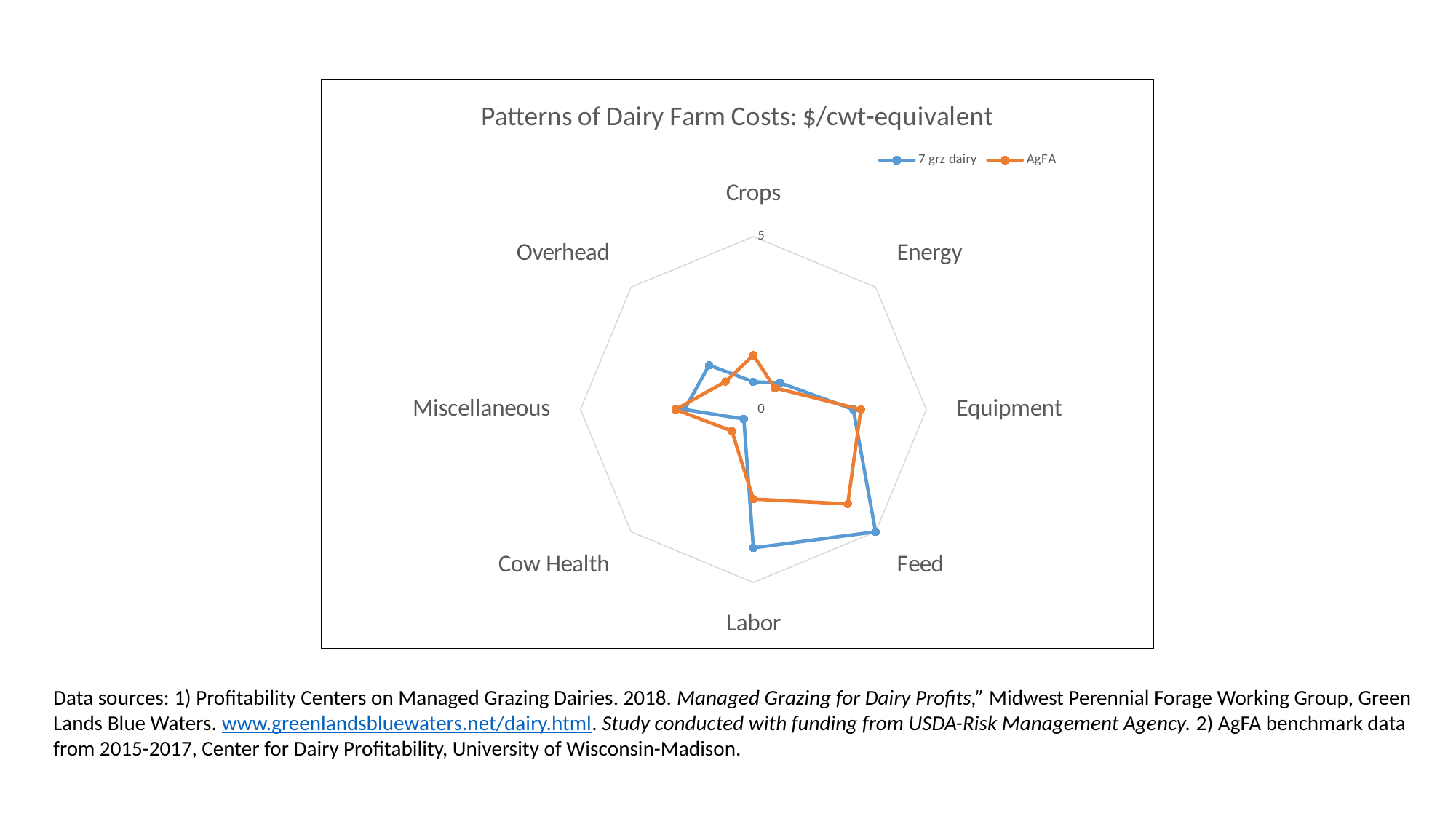
How many series does the legend list? 2 How many cost categories are plotted on the radar chart? 8 What kind of chart is shown on the slide? Radar chart For Labor, which series has the larger value, 7 grz dairy or AgFA? 7 grz dairy Which category has the highest value for the 7 grz dairy series? Feed What is the title of the chart? Patterns of Dairy Farm Costs: $/cwt-equivalent For Crops, which series has the larger value, 7 grz dairy or AgFA? AgFA What are the two series named in the legend? 7 grz dairy and AgFA Which category has the lowest value for the 7 grz dairy series? Cow Health Which category has the highest value for the AgFA series? Feed For Feed, which series has the larger value, 7 grz dairy or AgFA? 7 grz dairy